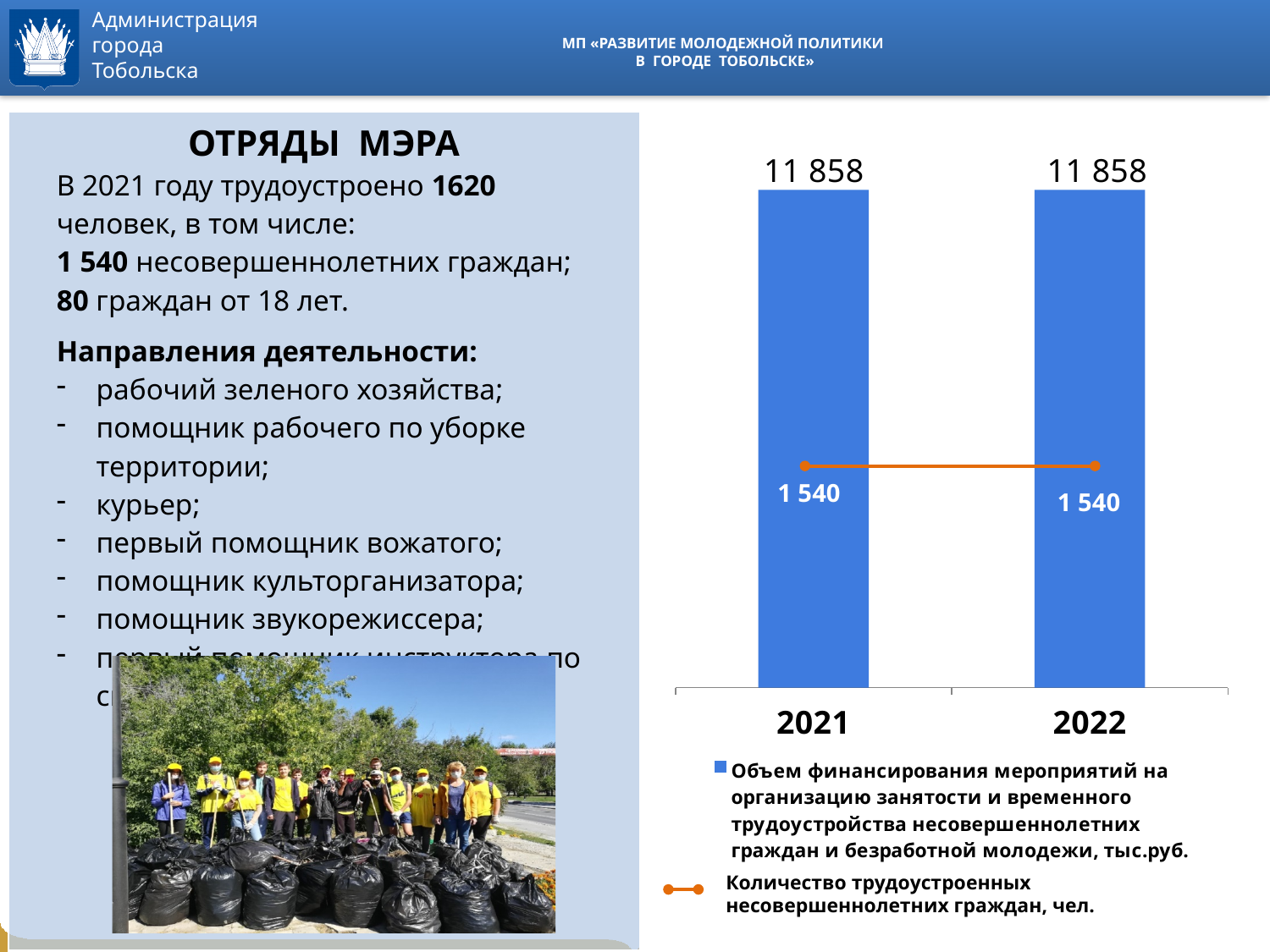
Do the bar values rise, fall or stay the same from 2021 to 2022? Stay the same What is the value of the line series (Количество трудоустроенных несовершеннолетних граждан, чел.) for 2022? 1 540 What is the value of the bar for 2021 in the chart? 11 858 What is the value of the bar for 2022 in the chart? 11 858 What is the value of the line series (Количество трудоустроенных несовершеннолетних граждан, чел.) for 2021? 1 540 What is the difference between the bar values for 2021 and 2022? 0 What kind of chart is shown on the slide? Combined bar and line chart What is the difference between the line values for 2021 and 2022? 0 Which series in the legend is shown as an orange line with markers? Количество трудоустроенных несовершеннолетних граждан, чел. How many categories (years) are shown on the x axis of the chart? 2 What colour are the bars in the chart? Blue How many series does the chart legend list? 2